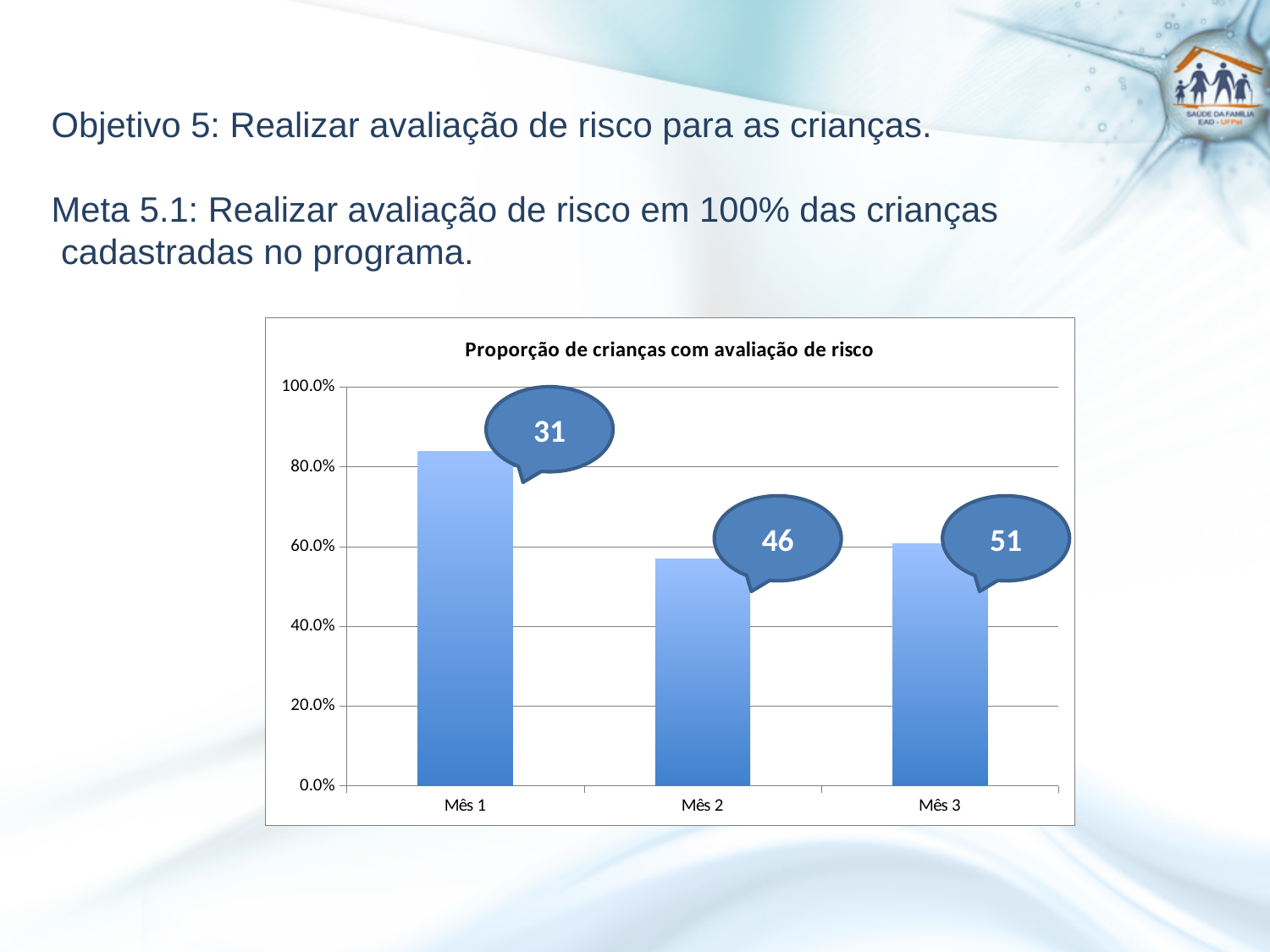
Which month has the highest proportion of children with risk assessment? Mês 1 What type of chart is shown on the slide? bar chart Does the value rise or fall from Mês 1 to Mês 2? fall What is the title of the chart? Proporção de crianças com avaliação de risco Which is larger, the value for Mês 1 or the value for Mês 2? Mês 1 Is the value for Mês 1 greater or less than 60.0%? greater Is the value for Mês 3 greater or less than 40.0%? greater What number is shown in the callout next to the Mês 2 bar? 46 Which month has the lowest proportion of children with risk assessment? Mês 2 Is the value for Mês 3 greater or less than 80.0%? less How many months (categories) are plotted on the chart? 3